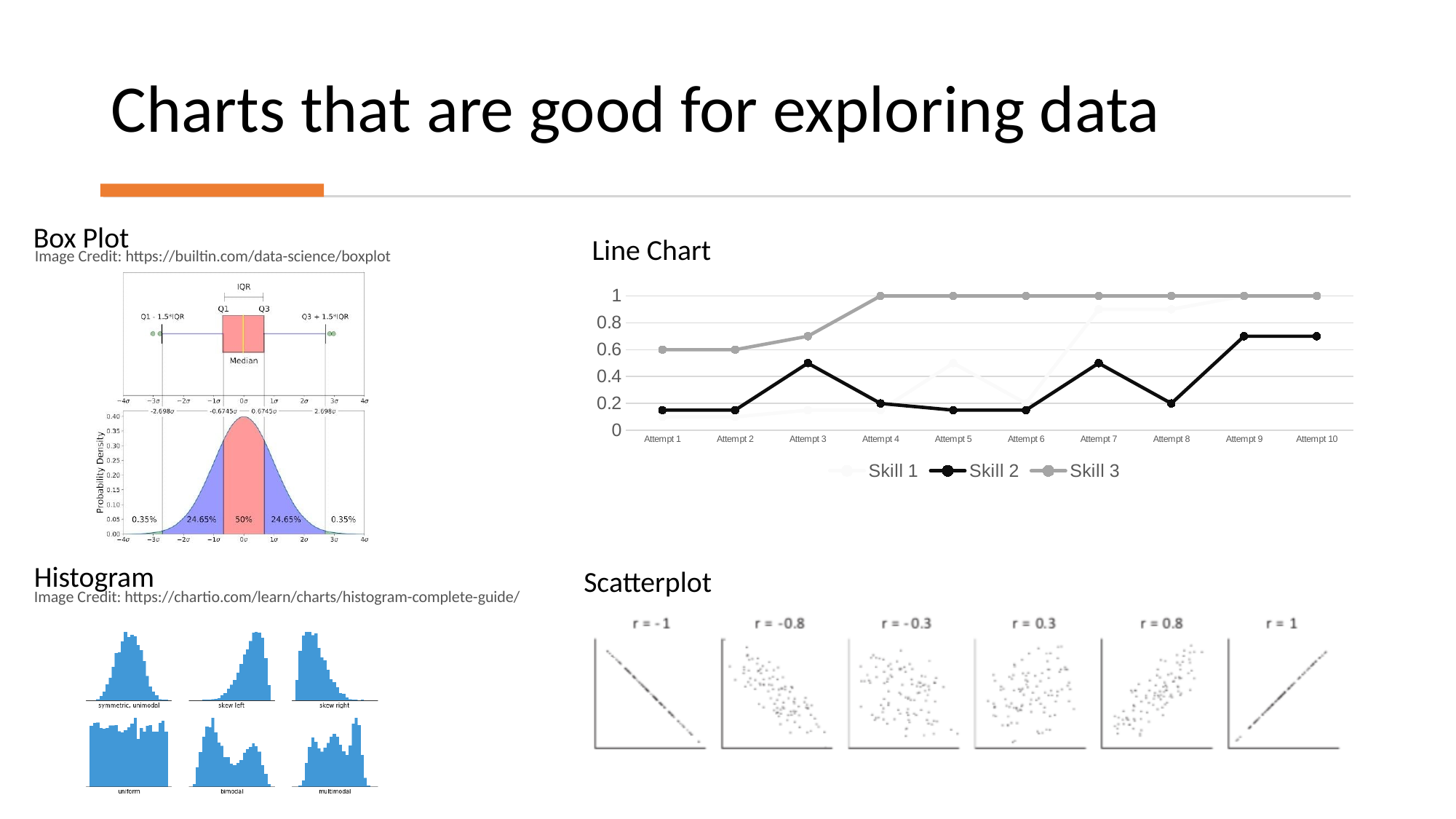
In the Line Chart, what is the value of Skill 2 at Attempt 4? 0.2 In the Line Chart, does Skill 3 rise or fall from Attempt 1 to Attempt 4? rises In the Line Chart, what is the value of Skill 3 at Attempt 1? 0.6 In the Line Chart, how many attempts are shown on the x axis? 10 In the Line Chart, what is the value of Skill 3 at Attempt 10? 1 In the Scatterplot section, how many scatterplot panels are shown? 6 In the Line Chart, which series has the higher value at Attempt 5, Skill 2 or Skill 3? Skill 3 What kind of chart is the Line Chart on the right of the slide? line chart In the Line Chart, is the value for Skill 2 at Attempt 9 greater or less than 0.6? greater In the Line Chart, is the value for Skill 2 at Attempt 3 greater or less than 0.4? greater In the Line Chart, what are the names of the series listed in the legend? Skill 1, Skill 2, Skill 3 In the Line Chart, how many series does the legend list? 3